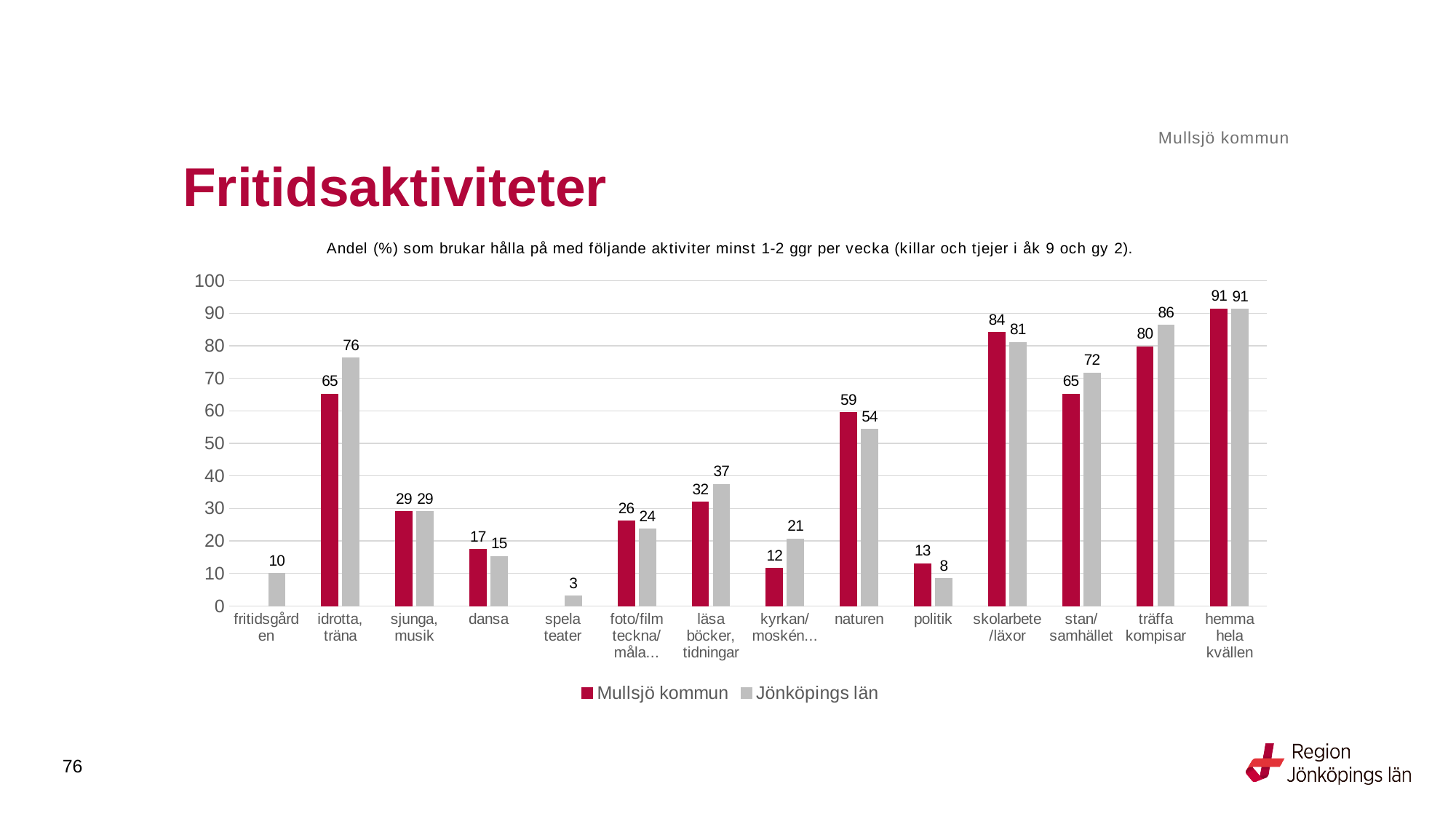
How many series does the legend list? 2 How many activity categories are shown on the x axis? 14 Which category has the lowest value for Jönköpings län? spela teater Which colour represents Mullsjö kommun in the chart? red What is the value for Jönköpings län for "kyrkan/moskén…"? 21 Which category has the highest value for Mullsjö kommun? hemma hela kvällen What is the difference between Jönköpings län and Mullsjö kommun for "idrotta, träna"? 11 Which is larger for "naturen": Mullsjö kommun or Jönköpings län? Mullsjö kommun What is the value for Jönköpings län for "spela teater"? 3 Which is larger for "stan/samhället": Mullsjö kommun or Jönköpings län? Jönköpings län What kind of chart is shown on the slide? bar chart What is the value for Mullsjö kommun for "idrotta, träna"? 65